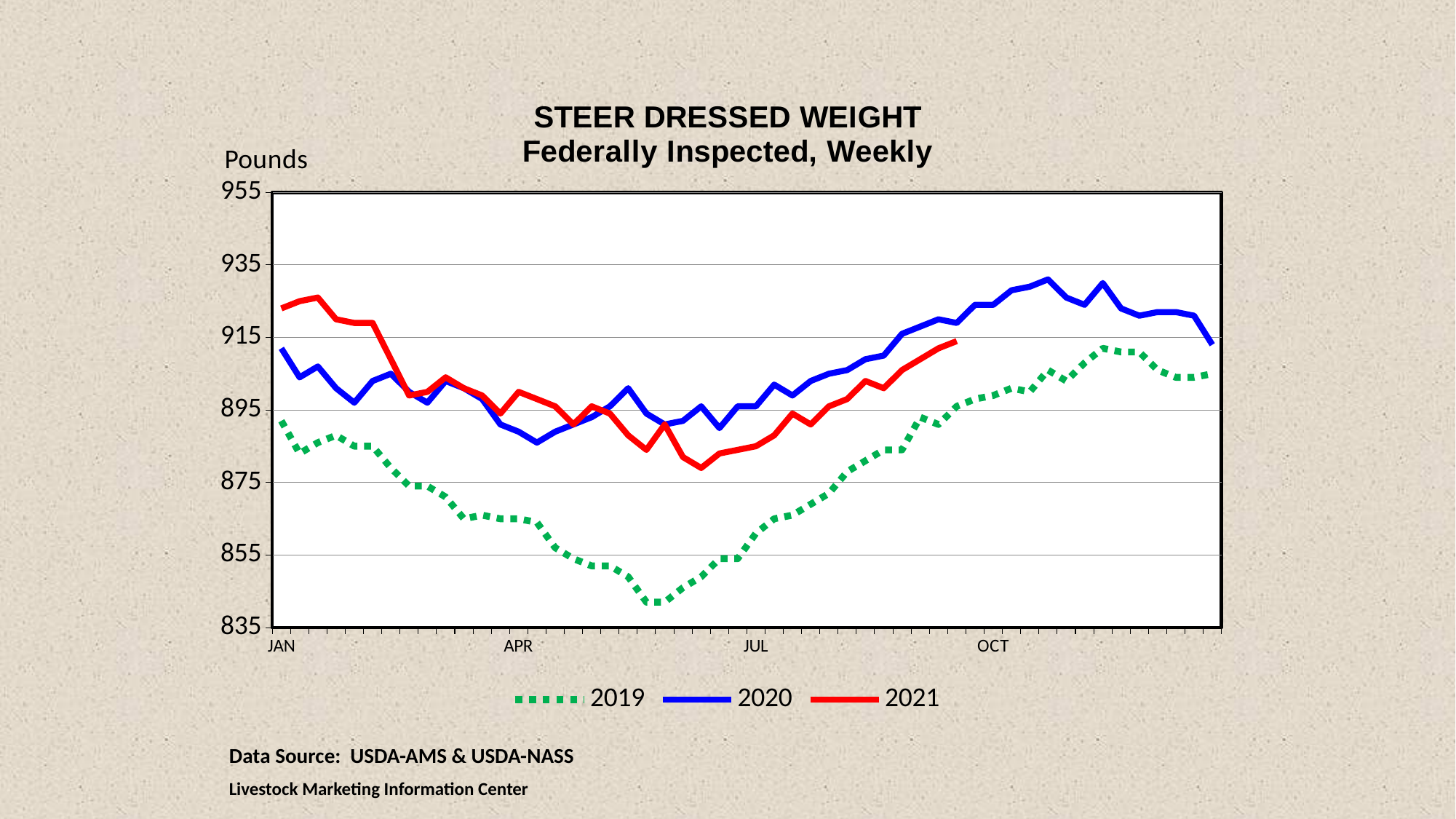
Is the lowest point of the 2019 line greater or less than 855? less Which series reaches the lowest value on the chart? 2019 Is the value for 2021 at JAN greater or less than 915? greater Is the highest point of the 2020 line greater or less than 915? greater At JUL, which series has the higher value, 2019 or 2020? 2020 Which years are listed in the legend? 2019, 2020, 2021 How many series does the legend list? 3 What unit is shown on the vertical axis label? Pounds What kind of chart is shown on the slide? line chart At JAN, which series has the higher value, 2019 or 2021? 2021 Does the 2019 line rise or fall between JUL and OCT? rise